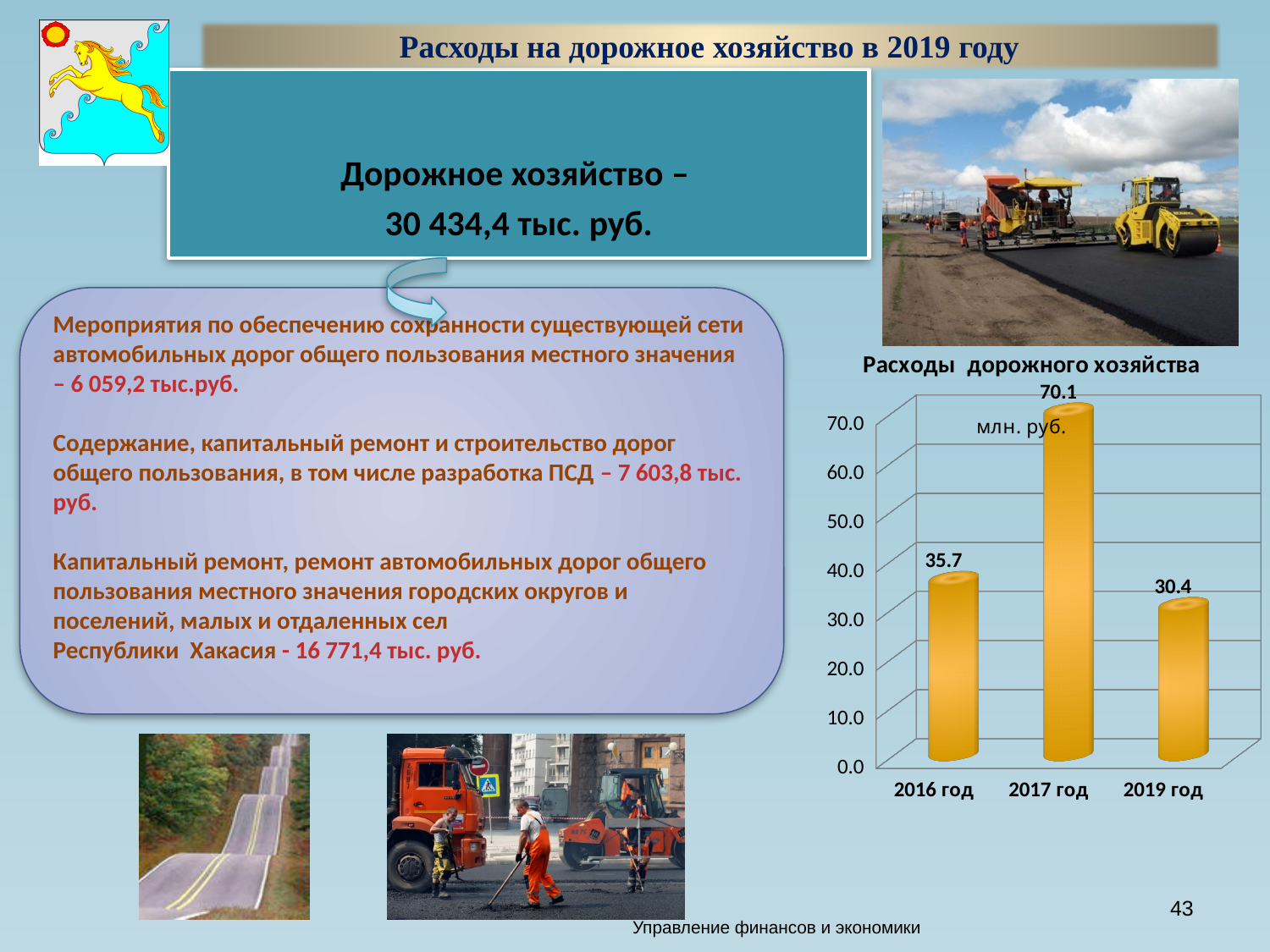
Which year has the highest value in the chart 'Расходы дорожного хозяйства'? 2017 год What is the difference between the values for 2017 год and 2019 год in the chart 'Расходы дорожного хозяйства'? 39.7 What unit is indicated on the chart 'Расходы дорожного хозяйства'? млн. руб. What kind of chart is 'Расходы дорожного хозяйства'? bar chart Is the value for 2017 год in the chart 'Расходы дорожного хозяйства' greater or less than 60.0? greater What is the value for 2017 год in the chart 'Расходы дорожного хозяйства'? 70.1 Which is larger in the chart 'Расходы дорожного хозяйства': the value for 2016 год or for 2019 год? 2016 год How many years are shown on the x axis of the chart 'Расходы дорожного хозяйства'? 3 What is the value for 2019 год in the chart 'Расходы дорожного хозяйства'? 30.4 Which year has the lowest value in the chart 'Расходы дорожного хозяйства'? 2019 год What is the difference between the values for 2016 год and 2019 год in the chart 'Расходы дорожного хозяйства'? 5.3 What is the value for 2016 год in the chart 'Расходы дорожного хозяйства'? 35.7